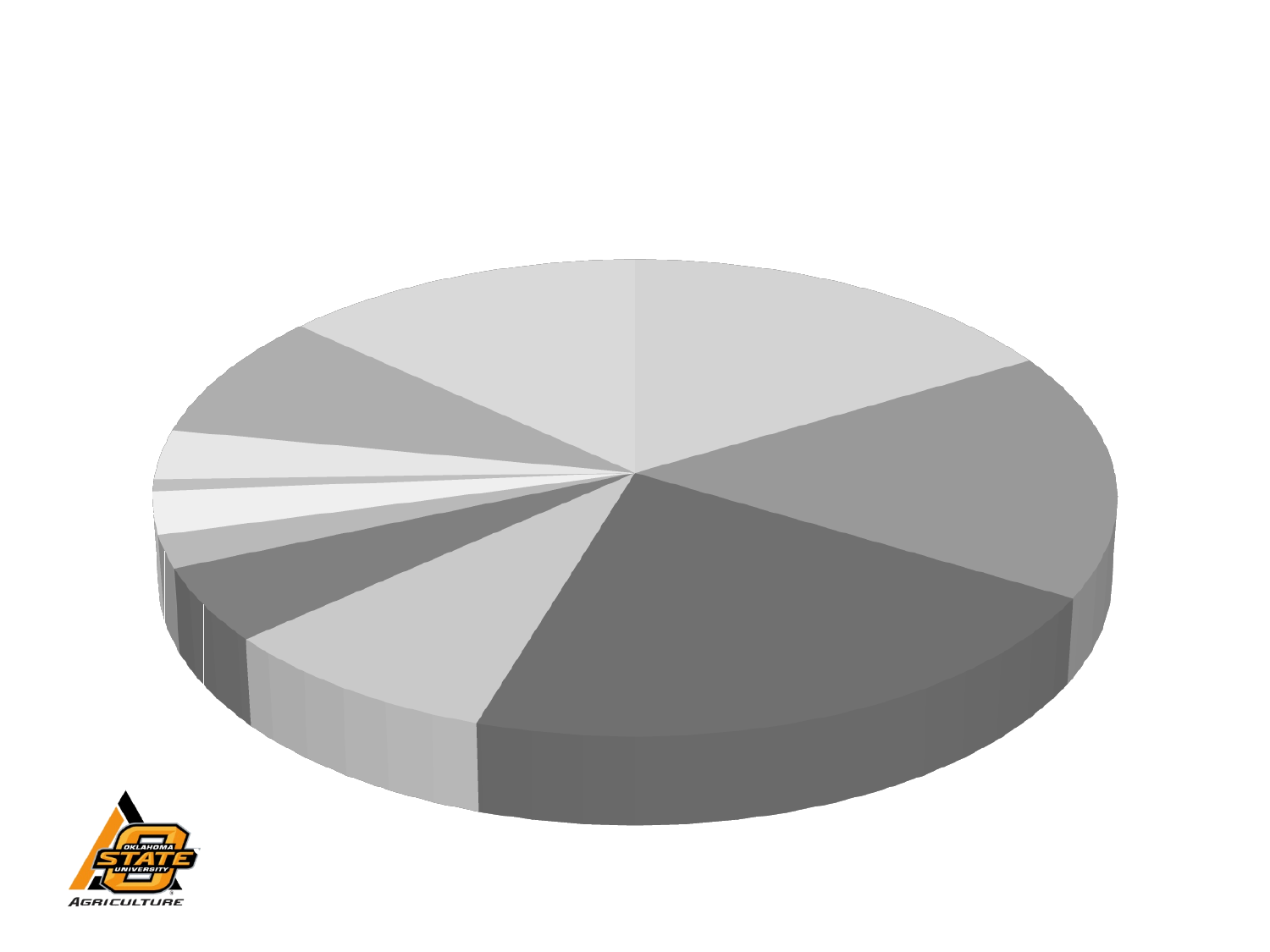
Is the pie chart drawn in 3D or flat 2D? 3D Which slice of the pie chart is the largest? the dark gray slice at the bottom Does the pie chart include a legend? No How many slices does the pie chart have? 11 What kind of chart is shown on the slide? pie chart